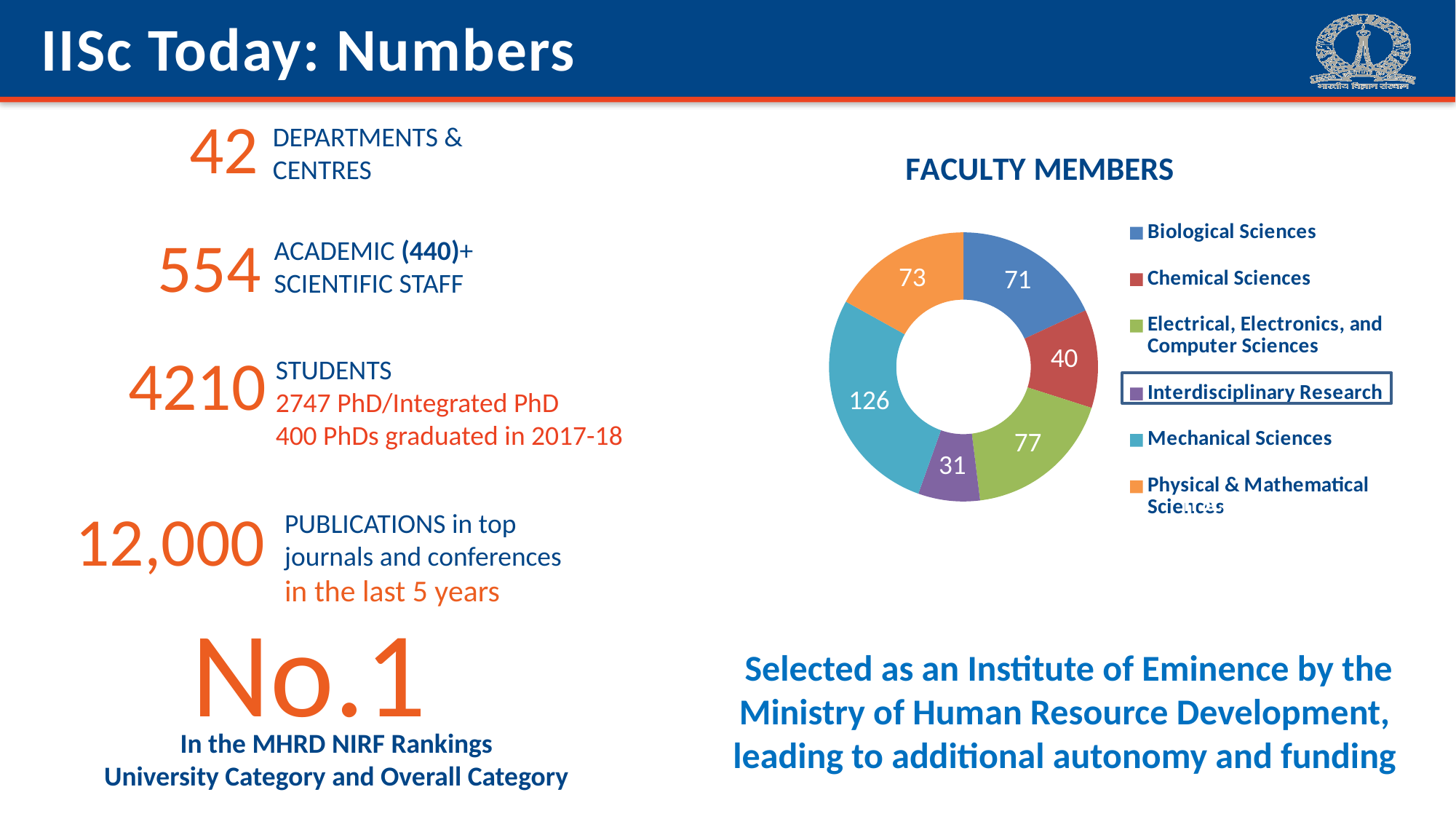
In the FACULTY MEMBERS chart, what is the difference between Mechanical Sciences and Biological Sciences? 55 In the FACULTY MEMBERS chart, which is larger: Electrical, Electronics, and Computer Sciences or Physical & Mathematical Sciences? Electrical, Electronics, and Computer Sciences In the FACULTY MEMBERS chart, which category has the largest number of faculty members? Mechanical Sciences In the FACULTY MEMBERS chart, what is the value for Physical & Mathematical Sciences? 73 In the FACULTY MEMBERS chart, which category has the smallest number of faculty members? Interdisciplinary Research In the FACULTY MEMBERS chart, how many faculty members are in Mechanical Sciences? 126 In the FACULTY MEMBERS chart legend, which category is shown in orange? Physical & Mathematical Sciences What is the total number of faculty members across all categories in the FACULTY MEMBERS chart? 418 How many categories does the FACULTY MEMBERS chart show? 6 In the FACULTY MEMBERS chart, what is the value for Interdisciplinary Research? 31 What type of chart is shown under the title FACULTY MEMBERS? doughnut chart In the FACULTY MEMBERS chart, what is the value for Chemical Sciences? 40